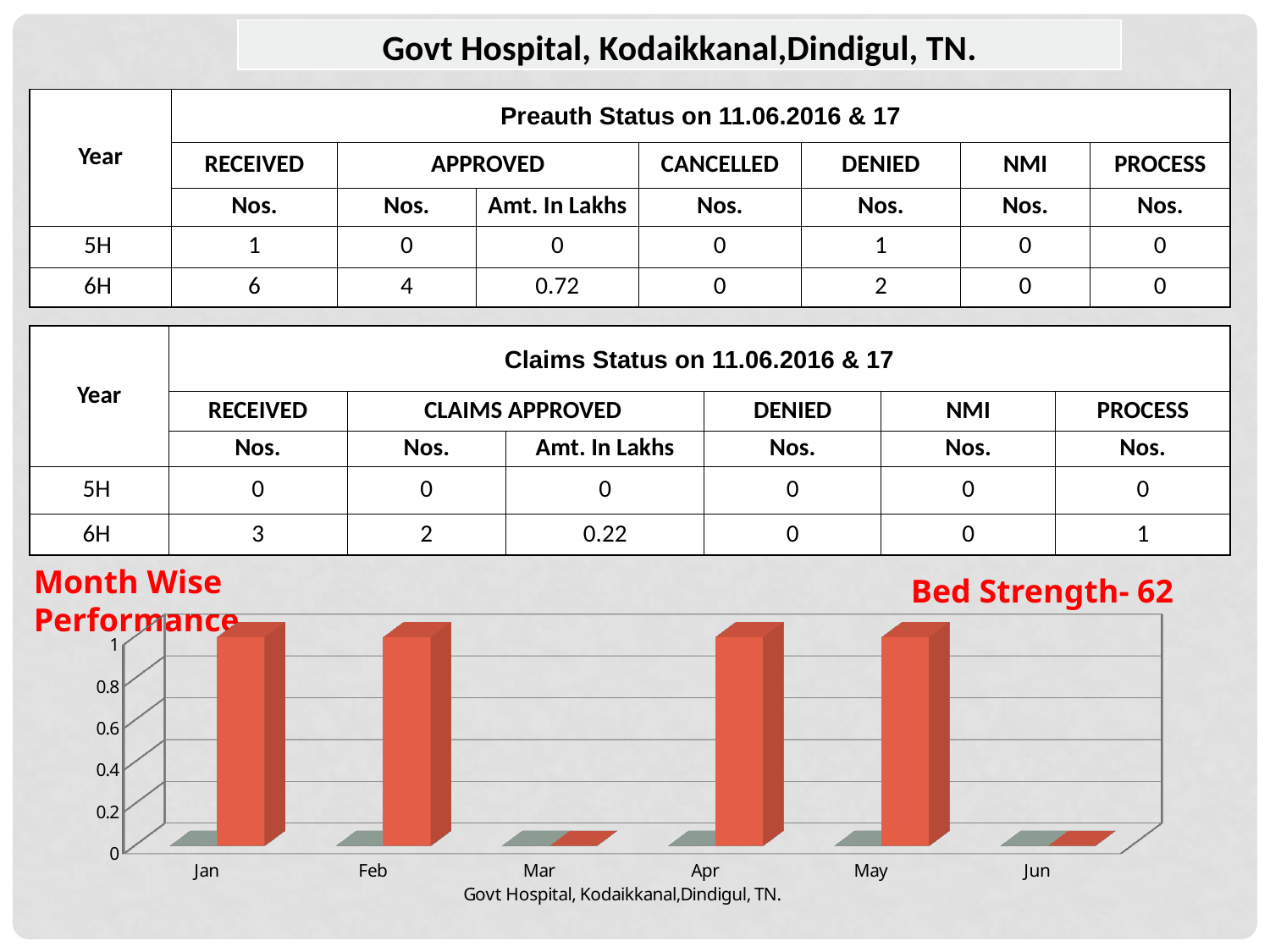
What is the value for Jun in the Month Wise Performance chart? 0 What is the value for Jan in the Month Wise Performance chart? 1 What is the value for Mar in the Month Wise Performance chart? 0 What is the highest value shown on the vertical axis of the Month Wise Performance chart? 1 What kind of chart is shown at the bottom of the slide? bar chart Which of Apr or Jun has the larger value in the Month Wise Performance chart? Apr What is the value for May in the Month Wise Performance chart? 1 What is the difference between the values for Jan and Mar in the Month Wise Performance chart? 1 What text appears below the x axis of the Month Wise Performance chart? Govt Hospital, Kodaikkanal,Dindigul, TN. Is the value for Apr in the Month Wise Performance chart greater or less than 0.6? greater Which of Feb or Mar has the larger value in the Month Wise Performance chart? Feb How many months are shown on the x axis of the Month Wise Performance chart? 6